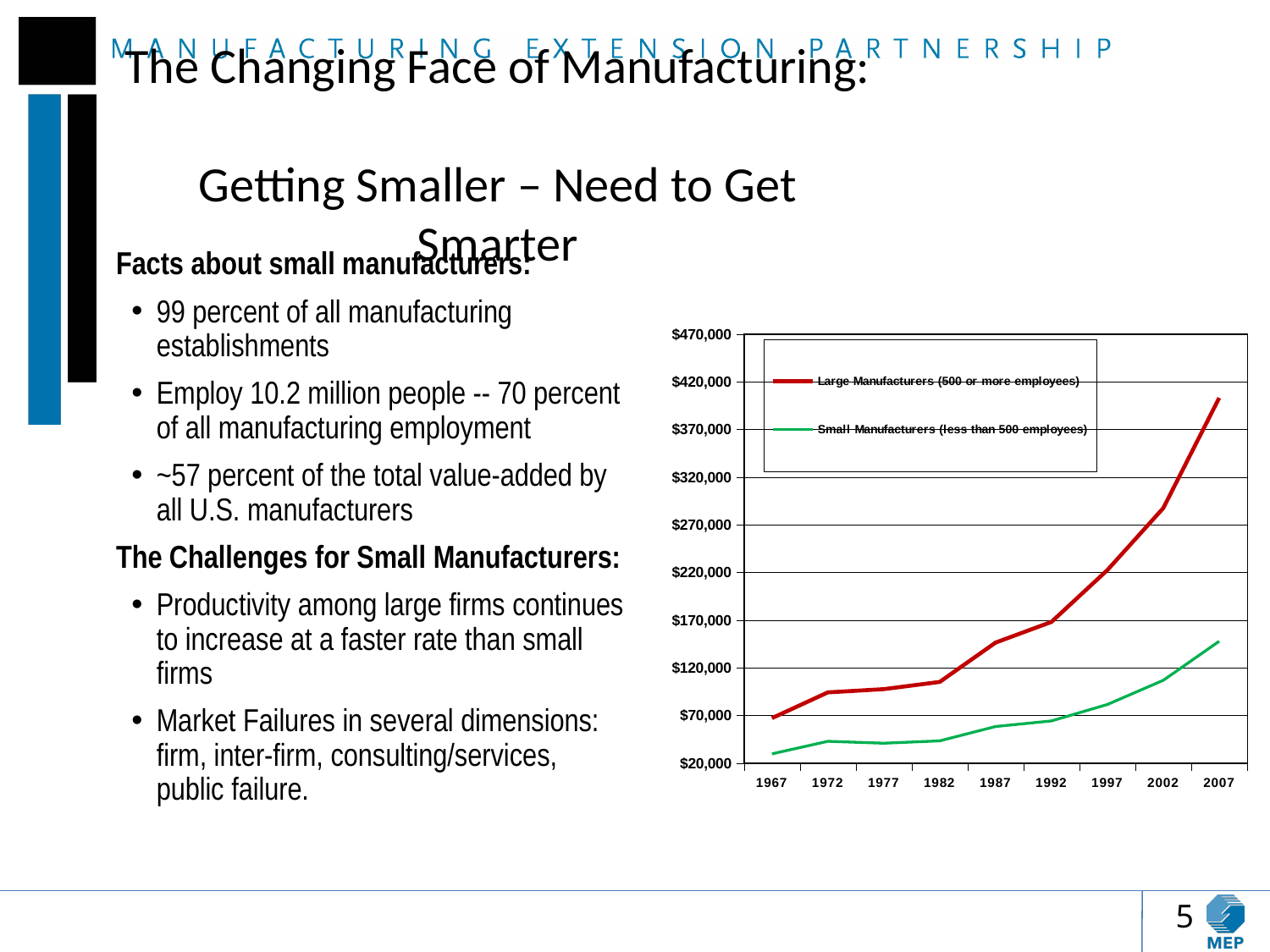
In which year does the Large Manufacturers series reach its highest value? 2007 In 2007, which series has the higher value, Large Manufacturers or Small Manufacturers? Large Manufacturers What is the first year shown on the x axis of the chart? 1967 What kind of chart is shown on the slide? Line chart How many series does the chart's legend list? 2 Is the value for Small Manufacturers in 1967 greater or less than $70,000? less Is the value for Large Manufacturers in 1992 greater or less than $220,000? less Which series is drawn in red on the chart? Large Manufacturers (500 or more employees) How many years are labelled on the x axis of the chart? 9 Is the value for Small Manufacturers in 2007 greater or less than $120,000? greater Do the values for Large Manufacturers generally rise or fall from 1967 to 2007? Rise